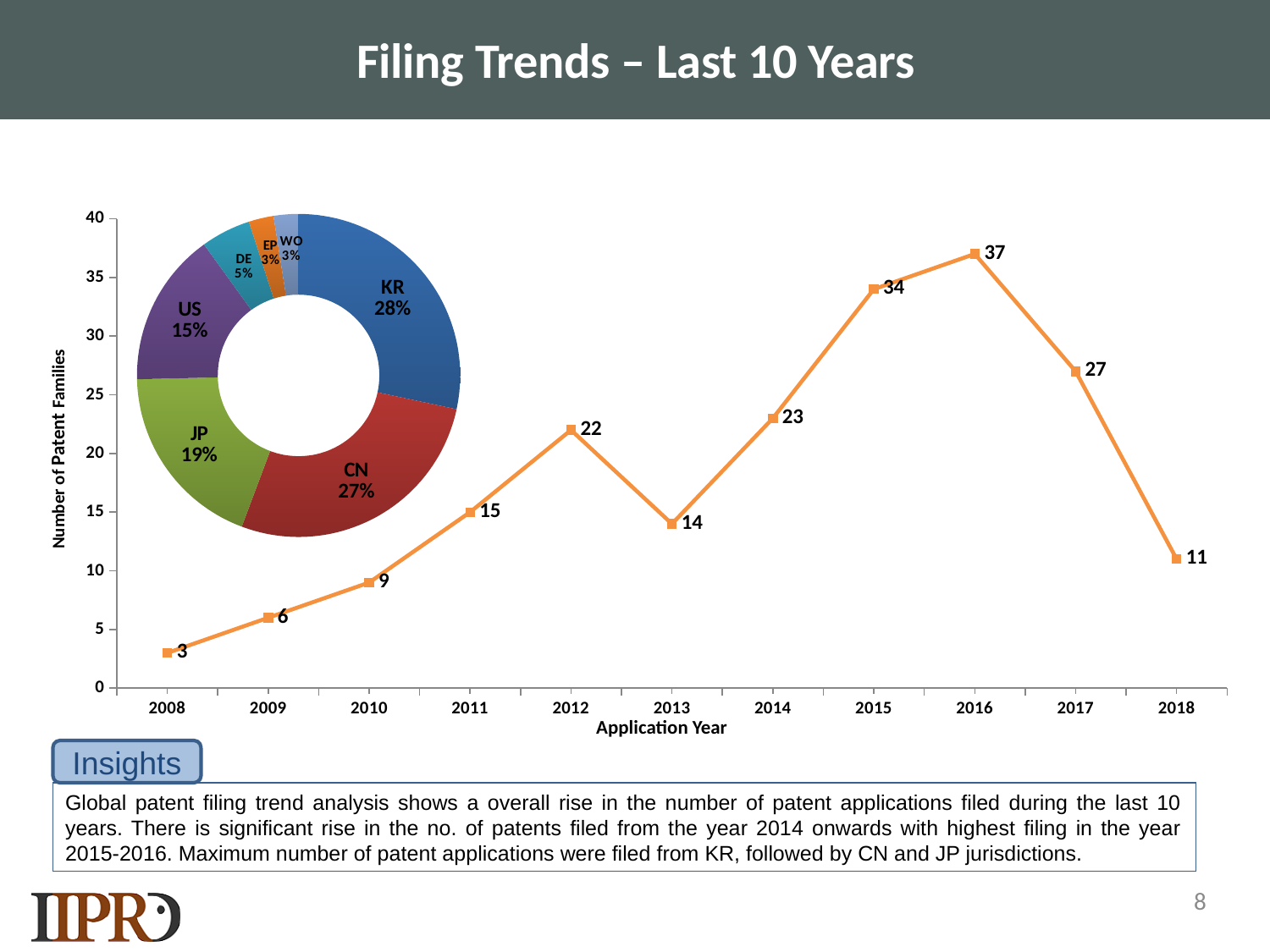
In the donut chart, what share of patent families is from KR? 28% In the line chart, which year has more patent families, 2012 or 2014? 2014 In the line chart, do the values rise or fall from 2016 to 2018? fall In the donut chart, which jurisdiction has the largest share? KR In the line chart, what is the difference in patent families between 2016 and 2018? 26 In the line chart, which application year has the highest number of patent families? 2016 In the line chart, which application year has the lowest number of patent families? 2008 In the donut chart, how many jurisdictions are shown? 7 What is the label of the x axis of the line chart? Application Year In the line chart, what is the number of patent families for 2013? 14 In the line chart, what is the number of patent families for 2016? 37 In the line chart, how many application years are plotted? 11